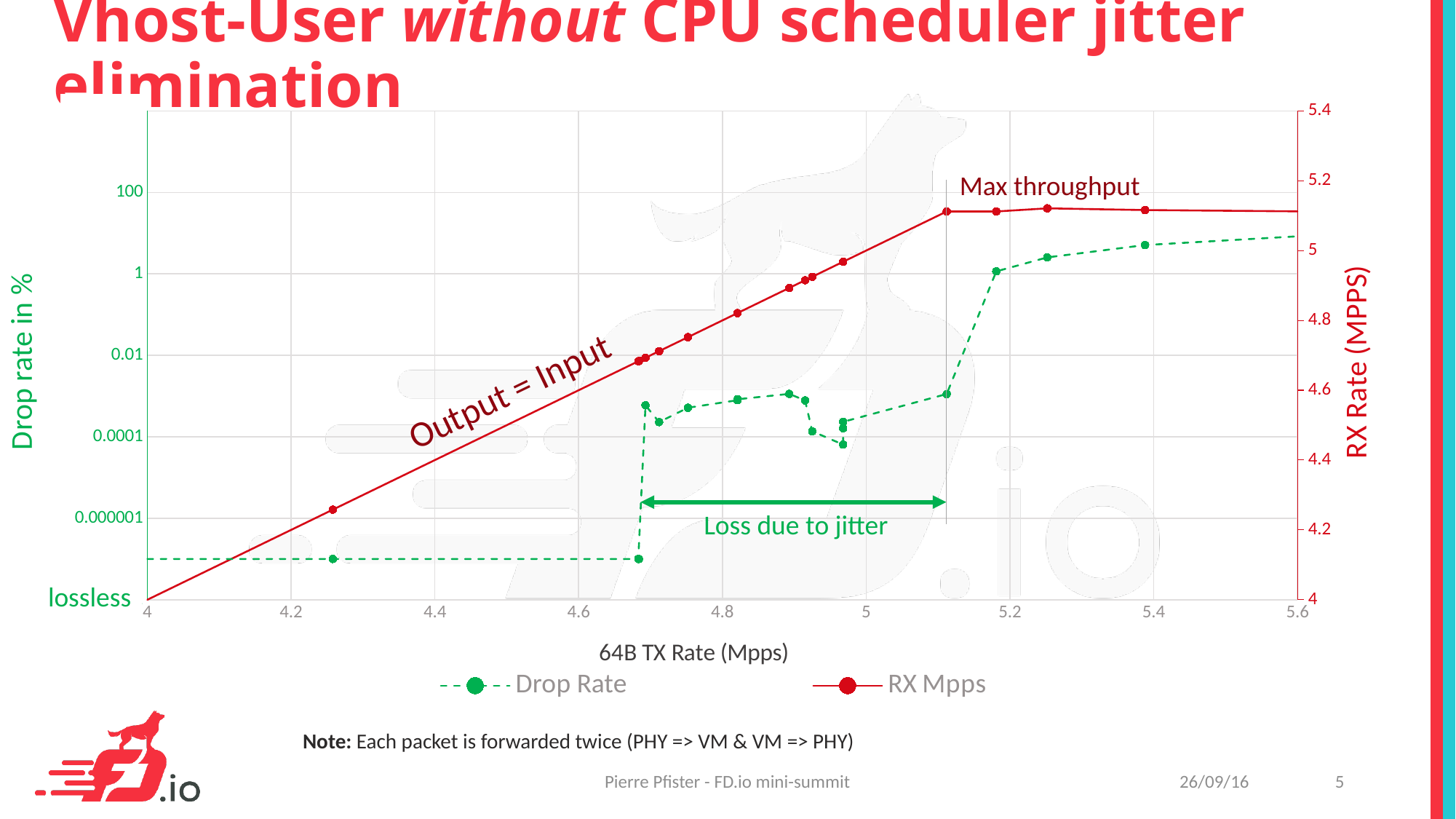
Is the Drop Rate at a 64B TX Rate of about 4.25 Mpps greater or less than 0.000001%? less Is the Drop Rate at a 64B TX Rate of about 4.8 Mpps greater or less than 0.01%? less Does the RX Mpps series rise or fall as the 64B TX Rate increases from 4 to 5.1 Mpps? rise What is the title of the x axis of the chart? 64B TX Rate (Mpps) Is the Drop Rate at a 64B TX Rate of about 5.4 Mpps greater or less than 1%? greater Does the Drop Rate series overall rise or fall as the 64B TX Rate increases from 4.6 to 5.6 Mpps? rise Which is larger: the Drop Rate at a 64B TX Rate of about 5.4 Mpps or at about 4.25 Mpps? at 5.4 Mpps How many series does the chart legend list? 2 What are the two series named in the chart legend? Drop Rate and RX Mpps What kind of chart is shown on the slide? line chart